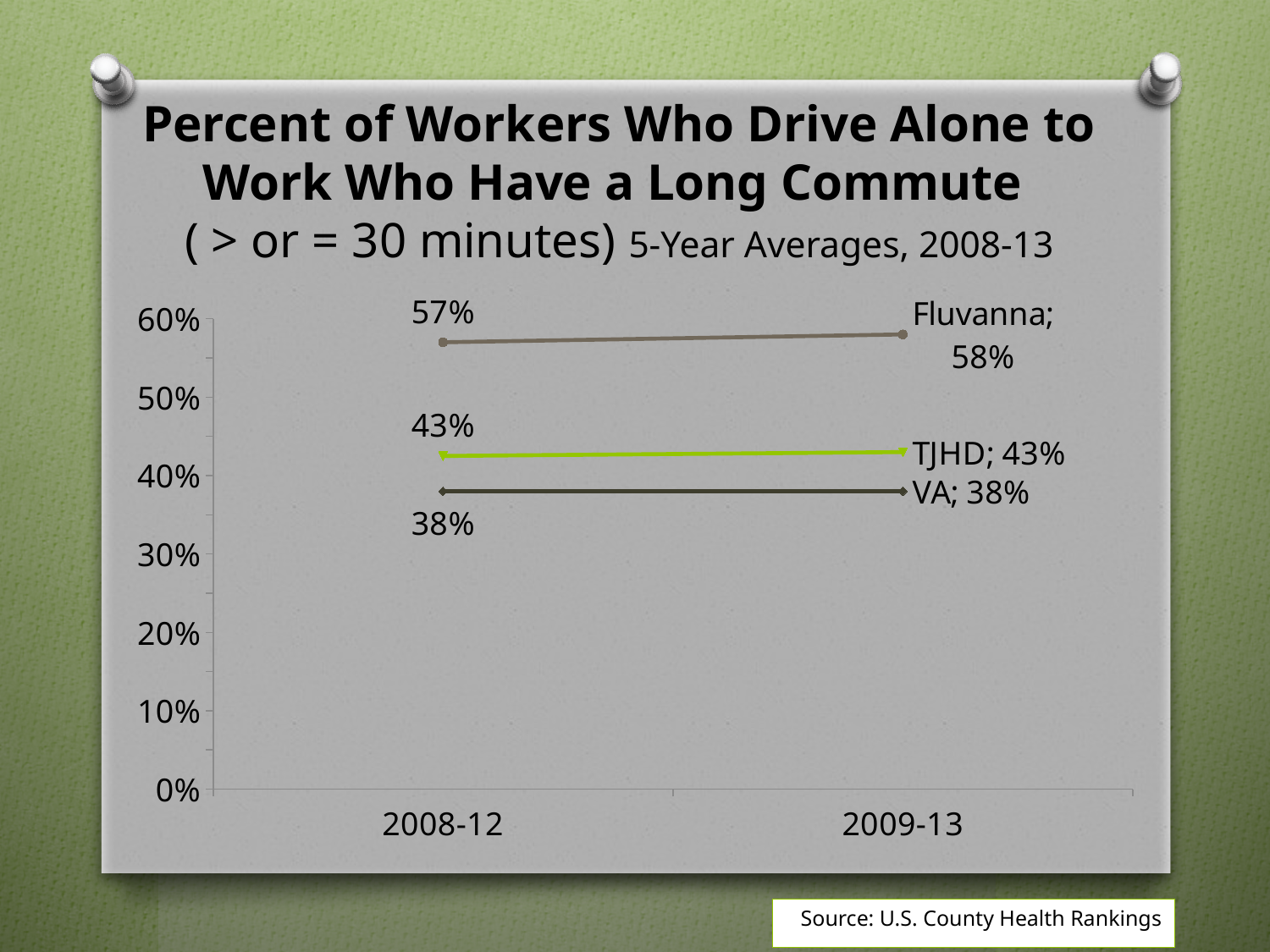
Which series has the lowest value in 2008-12? VA What kind of chart is shown on the slide? Line chart What is the value for Fluvanna in 2009-13? 58% Is the value for Fluvanna in 2009-13 greater or less than 50%? greater Which series has the highest value in 2009-13? Fluvanna Which is larger in 2009-13, TJHD or VA? TJHD What is the value for TJHD in 2009-13? 43% What is the value for Fluvanna in 2008-12? 57% What is the value for VA in 2008-12? 38% How many time periods are shown on the x axis? 2 What is the difference between Fluvanna and VA in 2009-13? 20% What is the difference between Fluvanna's 2008-12 and 2009-13 values? 1%